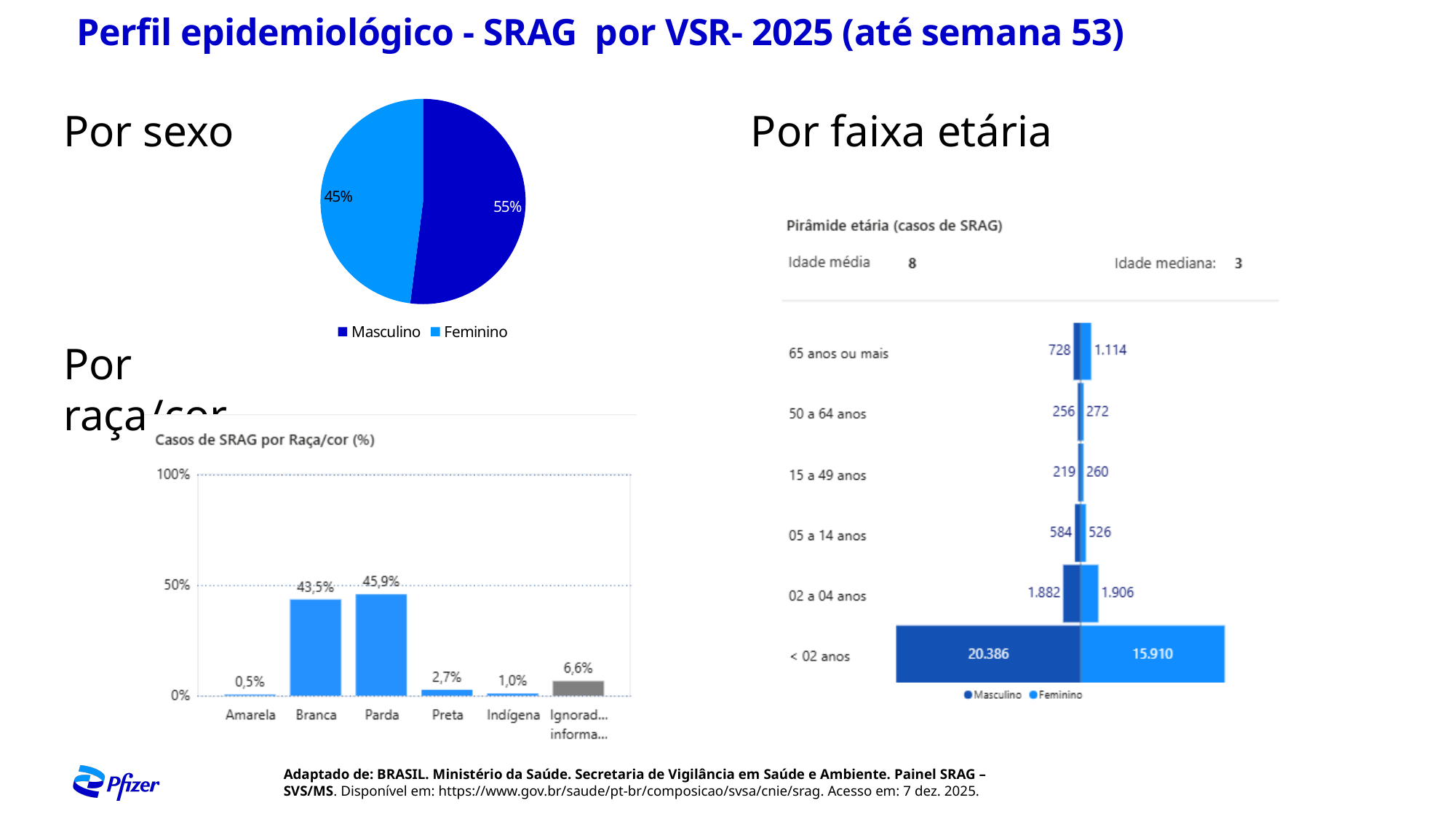
In the 'Casos de SRAG por Raça/cor (%)' chart, which category has the lowest value? Amarela In the 'Por sexo' pie chart, what share is Masculino? 55% In the 'Pirâmide etária (casos de SRAG)' chart, what is the Feminino value for '65 anos ou mais'? 1.114 In the 'Casos de SRAG por Raça/cor (%)' chart, what is the difference between Preta and Indígena? 1,7% In the 'Pirâmide etária (casos de SRAG)' chart, which is larger for '05 a 14 anos', Masculino or Feminino? Masculino In the 'Casos de SRAG por Raça/cor (%)' chart, what is the value for Branca? 43,5% In the 'Casos de SRAG por Raça/cor (%)' chart, which category has the highest value? Parda In the 'Casos de SRAG por Raça/cor (%)' chart, what is the value for Parda? 45,9% What kind of chart is the 'Por sexo' chart? Pie chart In the 'Casos de SRAG por Raça/cor (%)' chart, how many categories are shown on the x axis? 6 In the 'Pirâmide etária (casos de SRAG)' chart, what is the Masculino value for '< 02 anos'? 20.386 In the 'Por sexo' pie chart, what share is Feminino? 45%